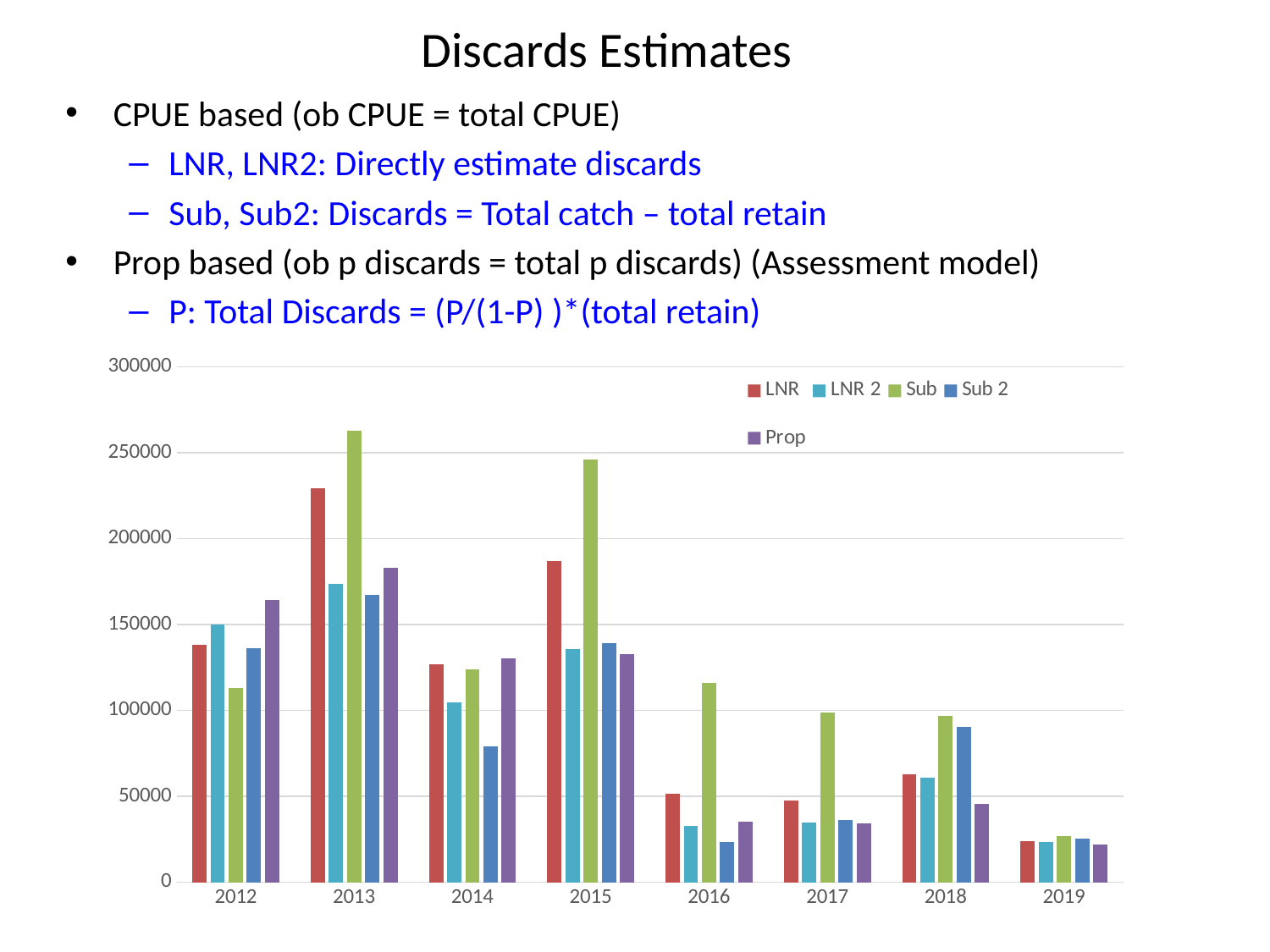
How many series does the chart legend list? 5 Which series has the lowest bar in 2016? Sub 2 In which year is the Sub series highest? 2013 Which series has the tallest bar in 2013? Sub How many years are shown on the x axis of the chart? 8 In 2012, which is larger: LNR or LNR 2? LNR 2 Is the value for Sub 2 in 2018 greater or less than 100000? less Is the value for Sub in 2013 greater or less than 250000? greater Does the LNR series rise or fall from 2015 to 2019? fall Is the value for LNR in 2015 greater or less than 200000? less What kind of chart is shown on the slide? bar chart